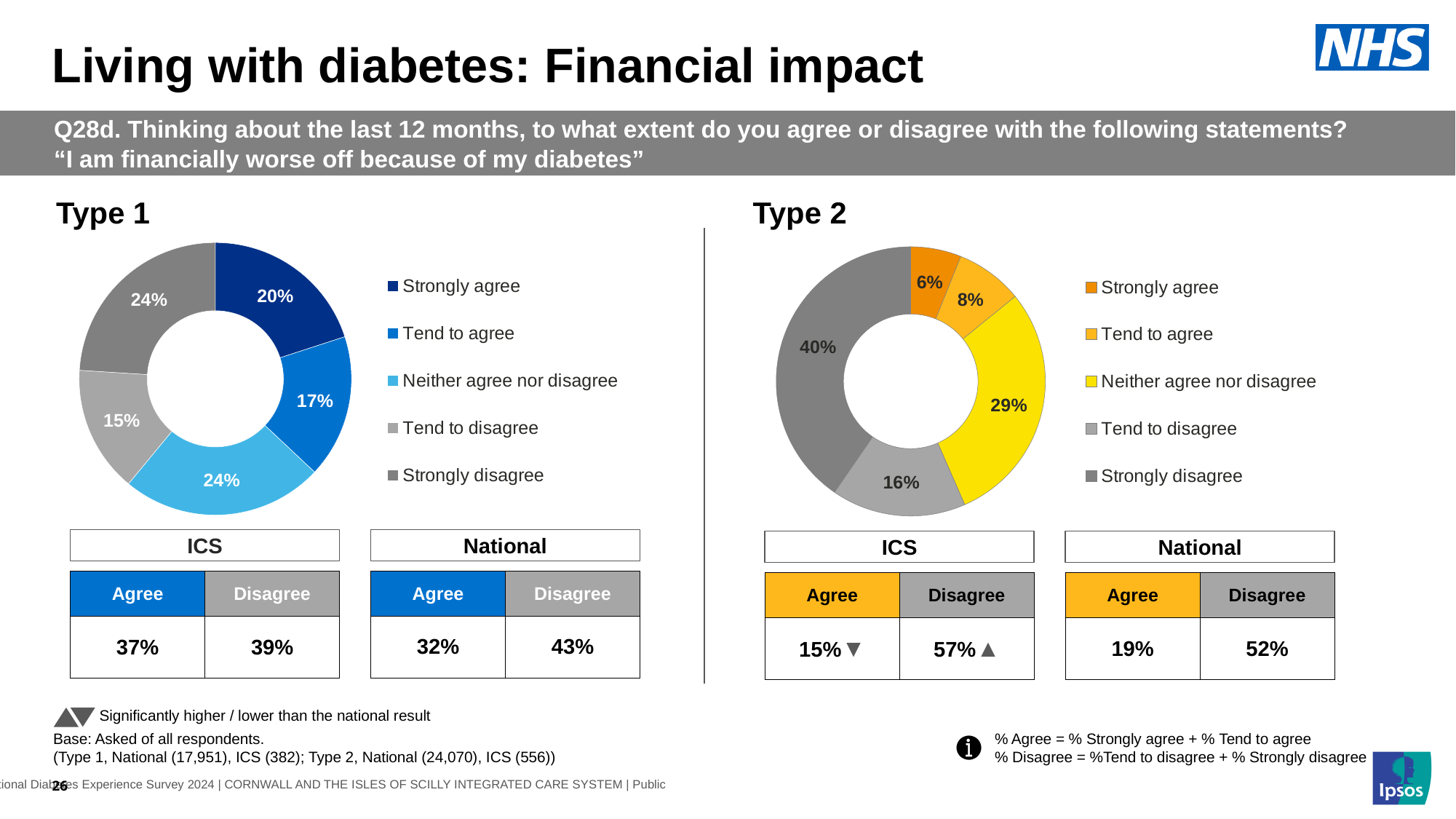
In the Type 2 chart, which is larger: the share for 'Tend to disagree' or the share for 'Tend to agree'? Tend to disagree In the Type 1 chart, which response category has the smallest share? Tend to disagree In the Type 2 chart, which response category has the smallest share? Strongly agree What type of chart is used to show the Type 2 results? Doughnut (pie) chart In the Type 2 chart, what percentage of respondents said they strongly disagree? 40% In the Type 2 chart, which response category has the largest share? Strongly disagree In the Type 2 chart, what colour is the 'Neither agree nor disagree' segment? Yellow In the Type 1 chart, what is the difference in percentage points between 'Strongly agree' and 'Tend to agree'? 3 percentage points In the Type 1 chart, what percentage of respondents said they strongly agree? 20% How many response categories does the legend of the Type 1 chart list? 5 In the Type 2 chart, what percentage of respondents said they neither agree nor disagree? 29% In the Type 1 chart, what percentage of respondents said they tend to agree? 17%